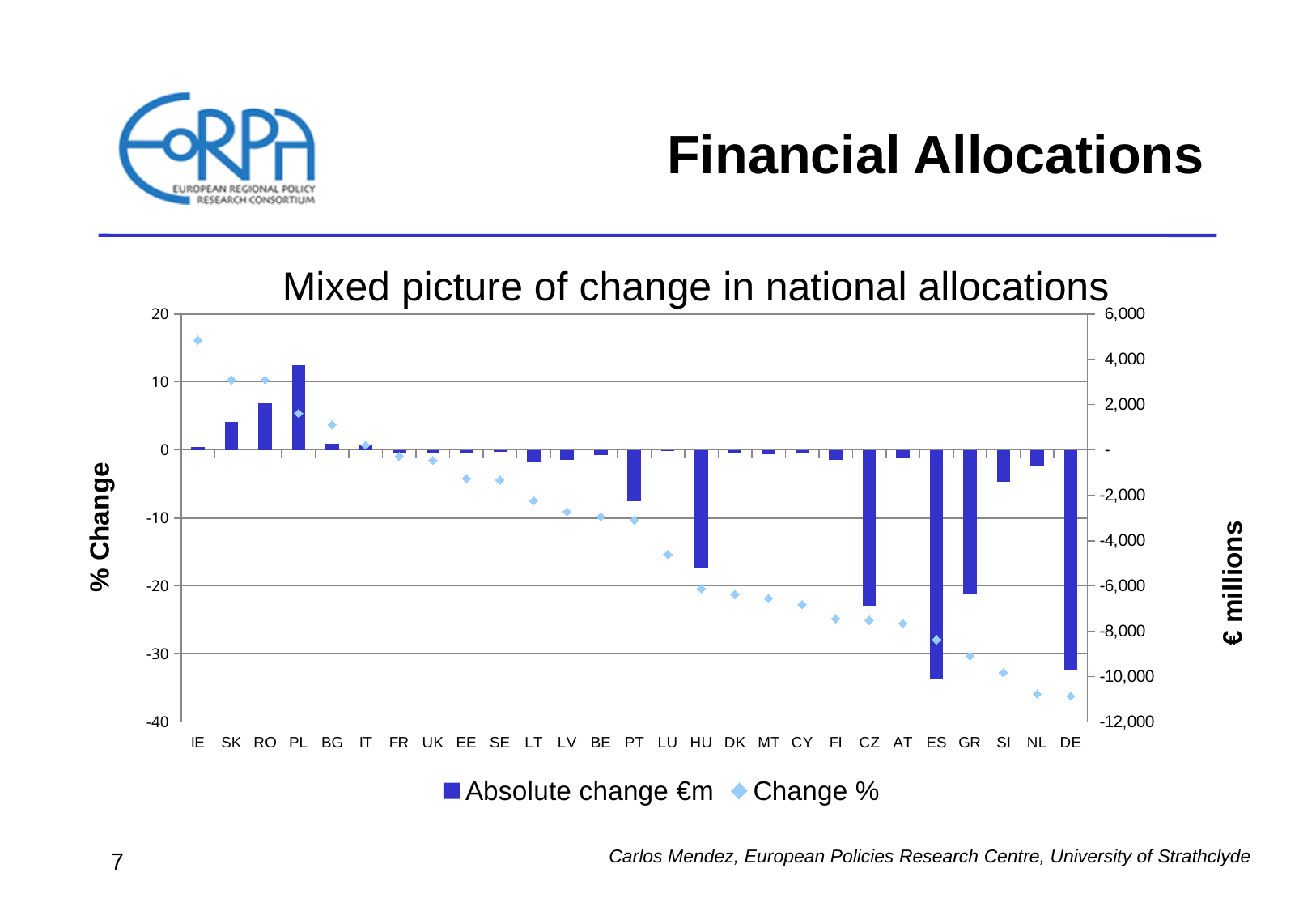
What is the title of the chart? Mixed picture of change in national allocations Is the Change % value for IE greater or less than 10? greater Do the Change % values generally rise or fall from left to right along the x axis? Fall How many series does the legend list? 2 Which country has the highest Change % value? IE What kind of chart is this? A bar chart combined with a marker (scatter) series How many countries are shown on the x axis of the chart? 27 Is the Absolute change €m value for PL greater or less than 2,000? greater What is the label of the right-hand vertical axis? € millions Which has the larger Absolute change €m bar, SK or RO? RO Which country has the highest Absolute change €m bar? PL Is the Absolute change €m value for HU greater or less than -4,000? less